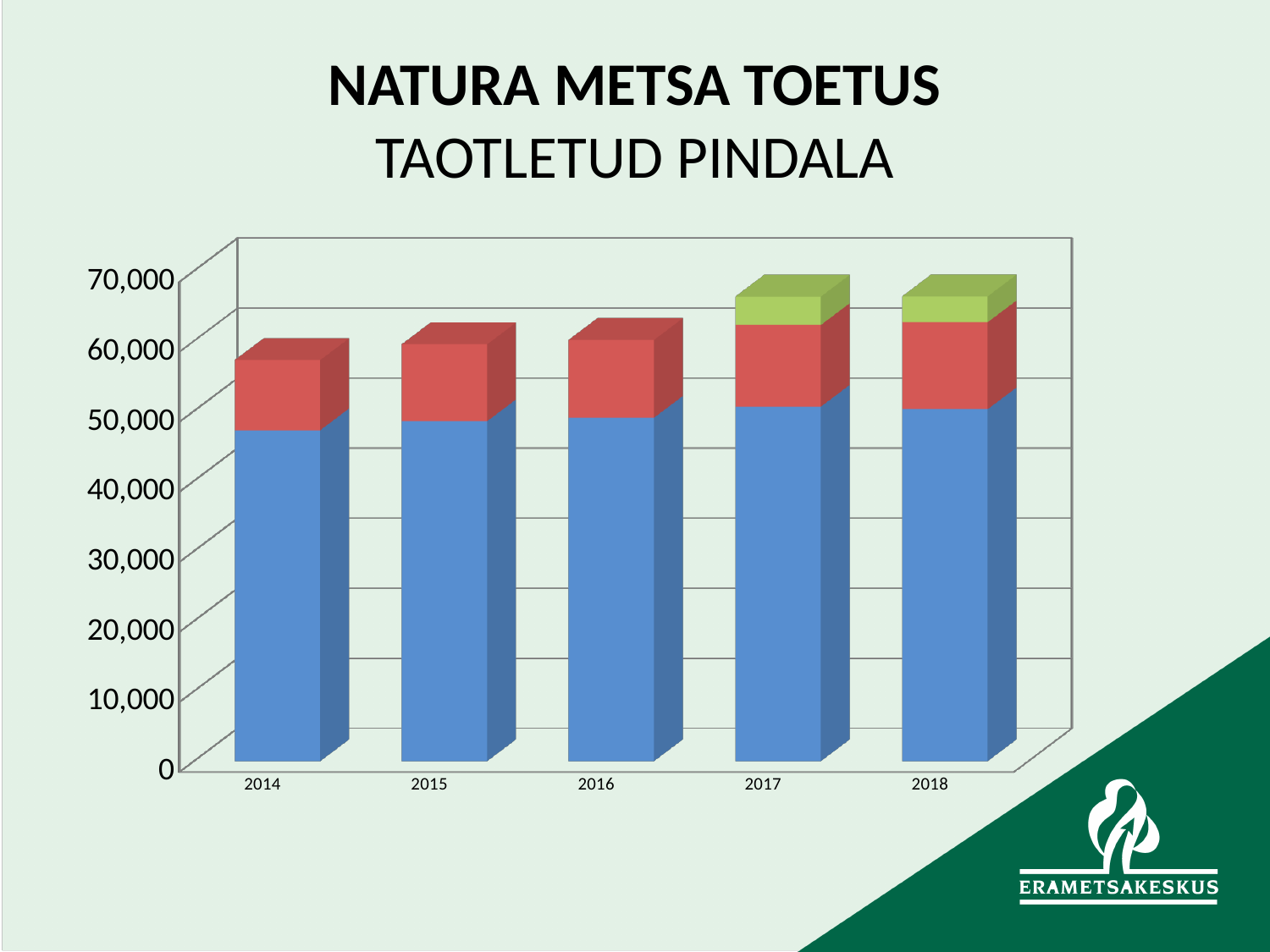
How many years are shown on the x axis of the chart? 5 What kind of chart is shown on the slide? stacked bar chart Which total bar is taller, 2016 or 2018? 2018 What is the title of the slide containing the chart? NATURA METSA TOETUS TAOTLETUD PINDALA Which total bar is taller, 2014 or 2017? 2017 Is the total bar for 2017 greater or less than 60,000? greater Which year has the lowest total bar in the chart? 2014 Is the total bar for 2014 greater or less than 50,000? greater Do the total bar heights generally rise or fall from 2014 to 2018? rise In which years does the bar include a green segment? 2017 and 2018 Is the total bar for 2015 greater or less than 40,000? greater